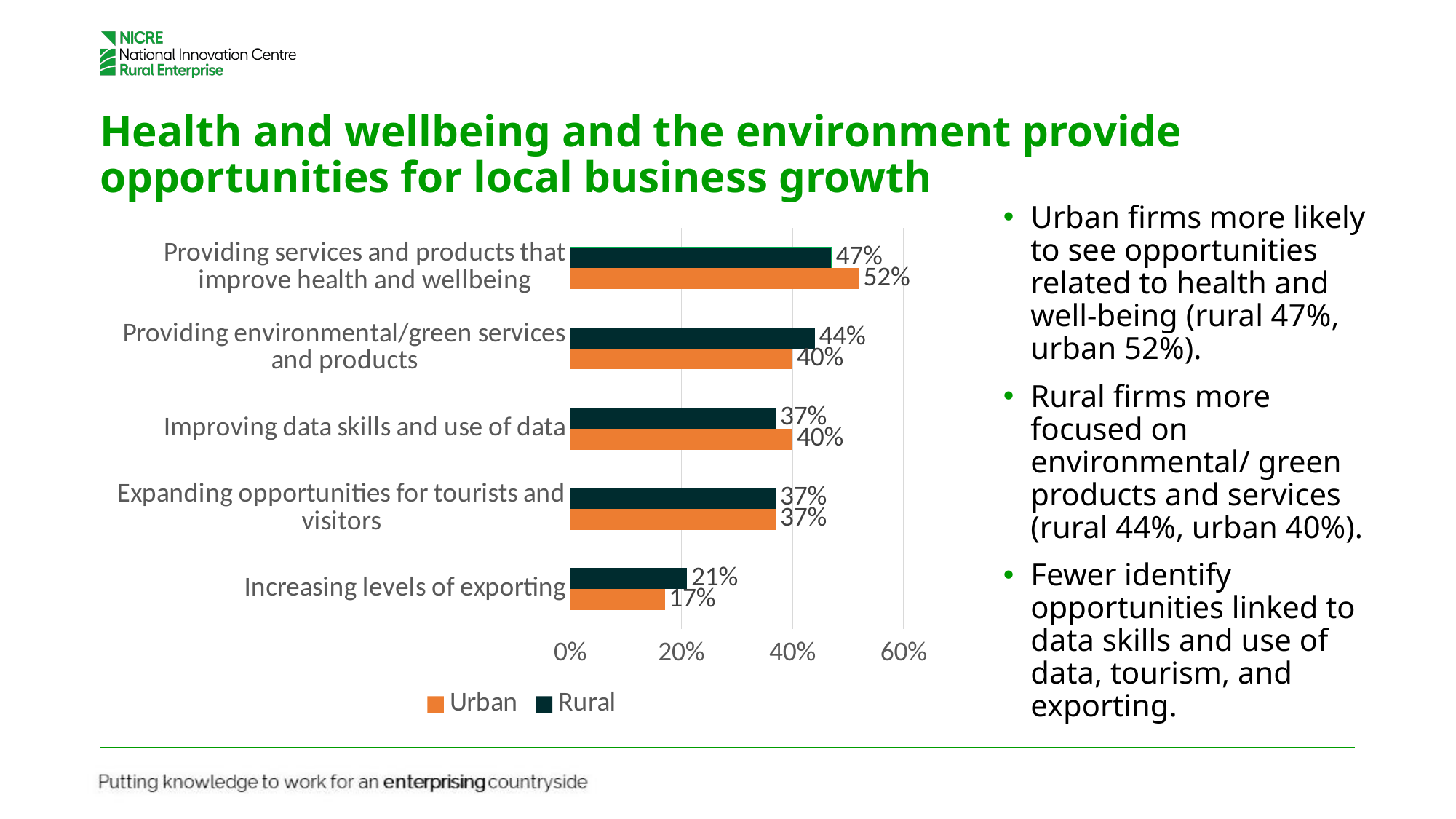
What is the Rural value for 'Providing environmental/green services and products'? 44% What is the Urban value for 'Increasing levels of exporting'? 17% Which category has the highest Rural value? Providing services and products that improve health and wellbeing How many categories are shown on the chart? 5 Which colour represents the Rural series in the chart? Dark green Which category has the lowest Urban value? Increasing levels of exporting What is the difference between the Urban and Rural values for 'Providing services and products that improve health and wellbeing'? 5% Is the Rural value for 'Increasing levels of exporting' greater or less than 40%? less Which is larger for 'Improving data skills and use of data', the Urban value or the Rural value? Urban What kind of chart is shown on the slide? Bar chart What is the Urban value for 'Providing services and products that improve health and wellbeing'? 52% How many series does the legend list? 2